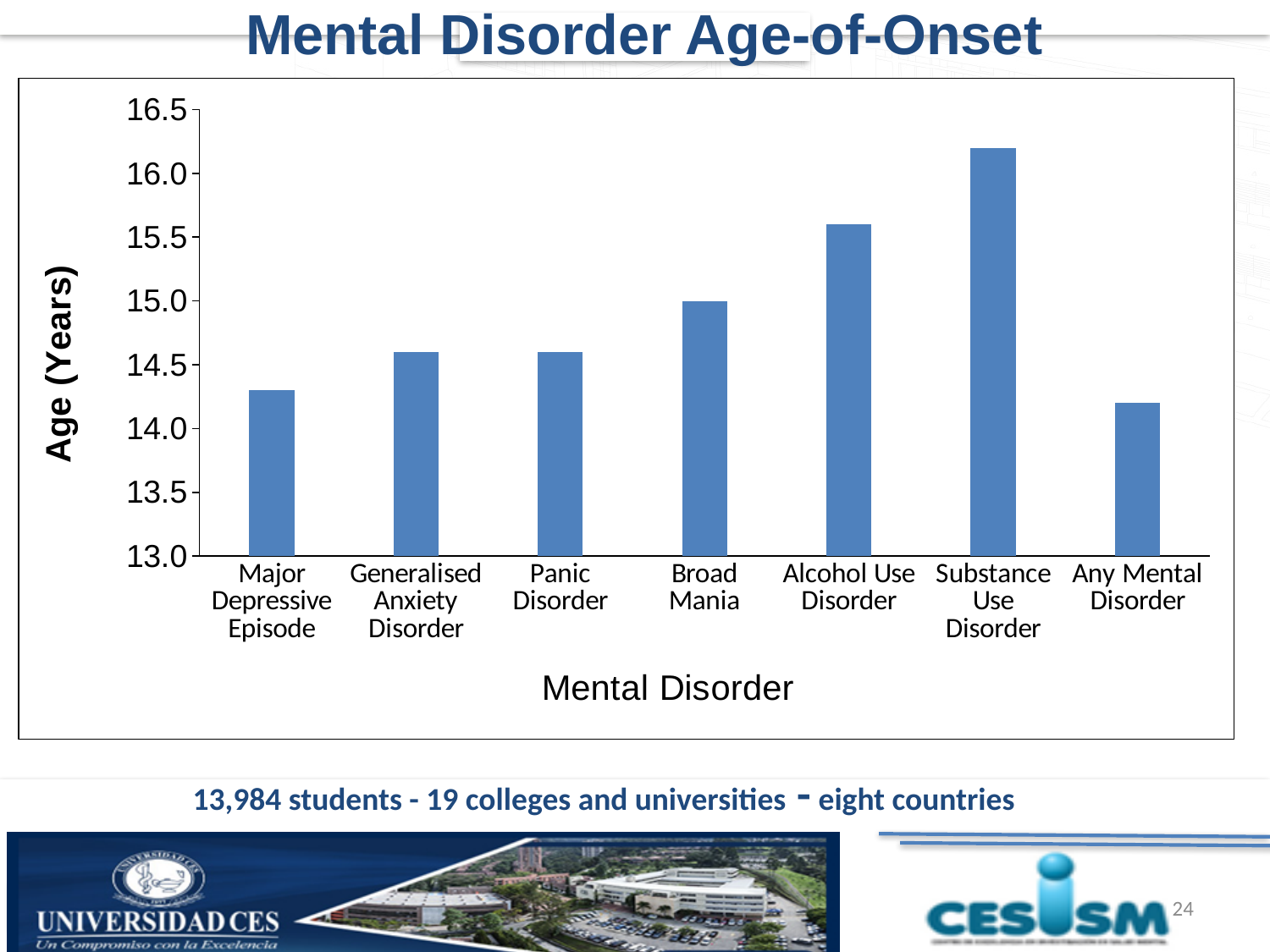
What is the age of onset for Broad Mania? 15.0 What type of chart is shown on the slide? Bar chart What is the title of the chart? Mental Disorder Age-of-Onset Is the age of onset for Major Depressive Episode greater or less than 14.5? less How many mental disorder categories are plotted on the x axis? 7 Is the age of onset for Alcohol Use Disorder greater or less than 15.5? greater Which has a higher age of onset, Alcohol Use Disorder or Broad Mania? Alcohol Use Disorder What is the title of the y axis? Age (Years) Which mental disorder has the highest age of onset? Substance Use Disorder Is the age of onset for Substance Use Disorder greater or less than 16.0? greater